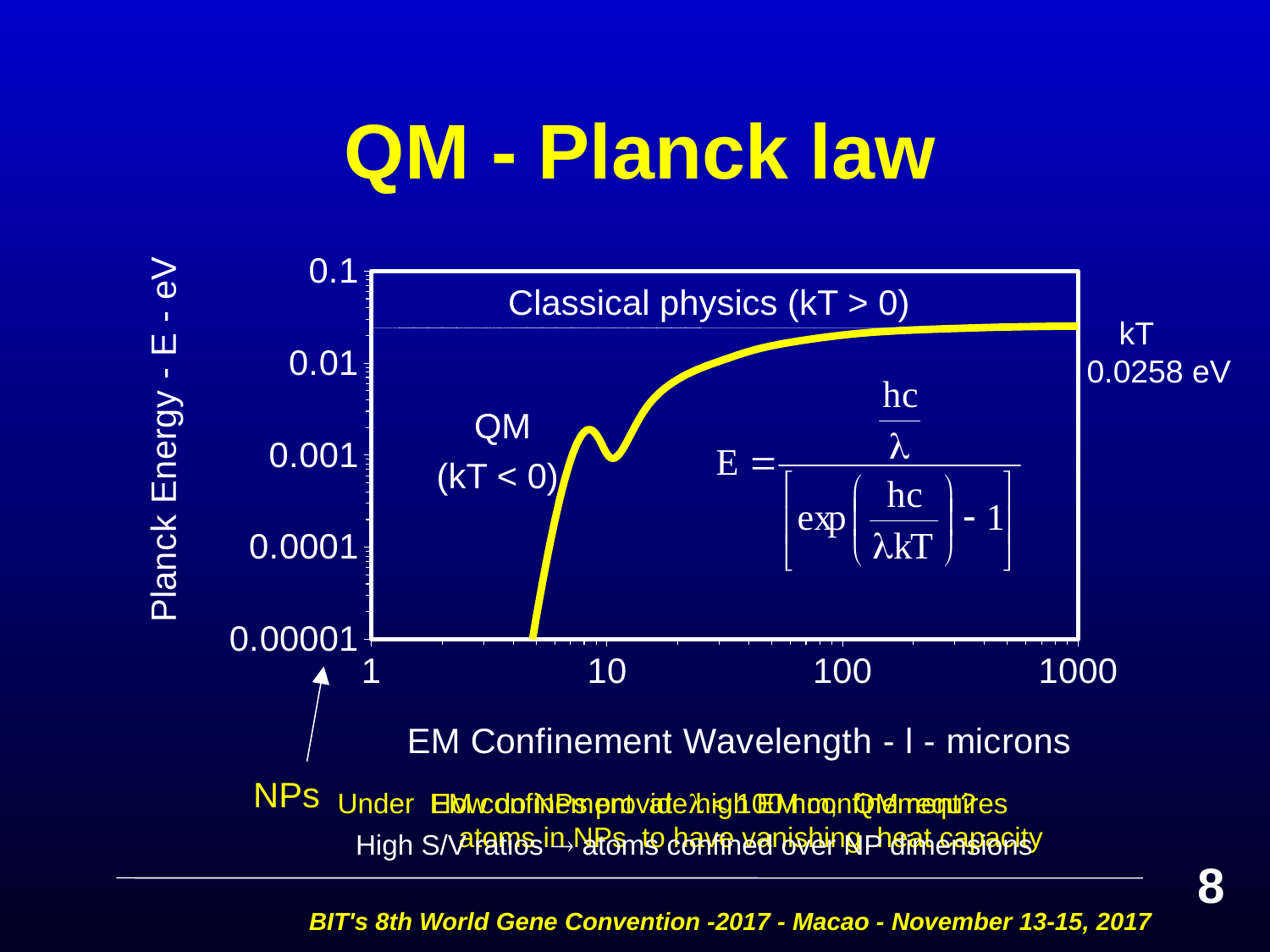
What is the lowest value labelled on the y axis of the chart? 0.00001 Is the Planck energy at a wavelength of 100 microns greater or less than 0.001 eV? greater Is the Planck energy at a wavelength of 1000 microns greater or less than 0.01 eV? greater Is the Planck energy at a wavelength of 1000 microns greater or less than 0.1 eV? less What kind of chart is shown on the slide? line chart How many tick labels are shown on the y axis of the chart? 5 What is the label of the y axis of the chart? Planck Energy - E - eV What is the title of the slide containing the chart? QM - Planck law Does the plotted Planck energy curve generally rise or fall as the EM confinement wavelength increases from 1 to 1000 microns? rise What value of kT is printed next to the horizontal reference line on the chart? 0.0258 eV What is the highest value labelled on the x axis of the chart? 1000 How many tick labels are shown on the x axis of the chart? 4